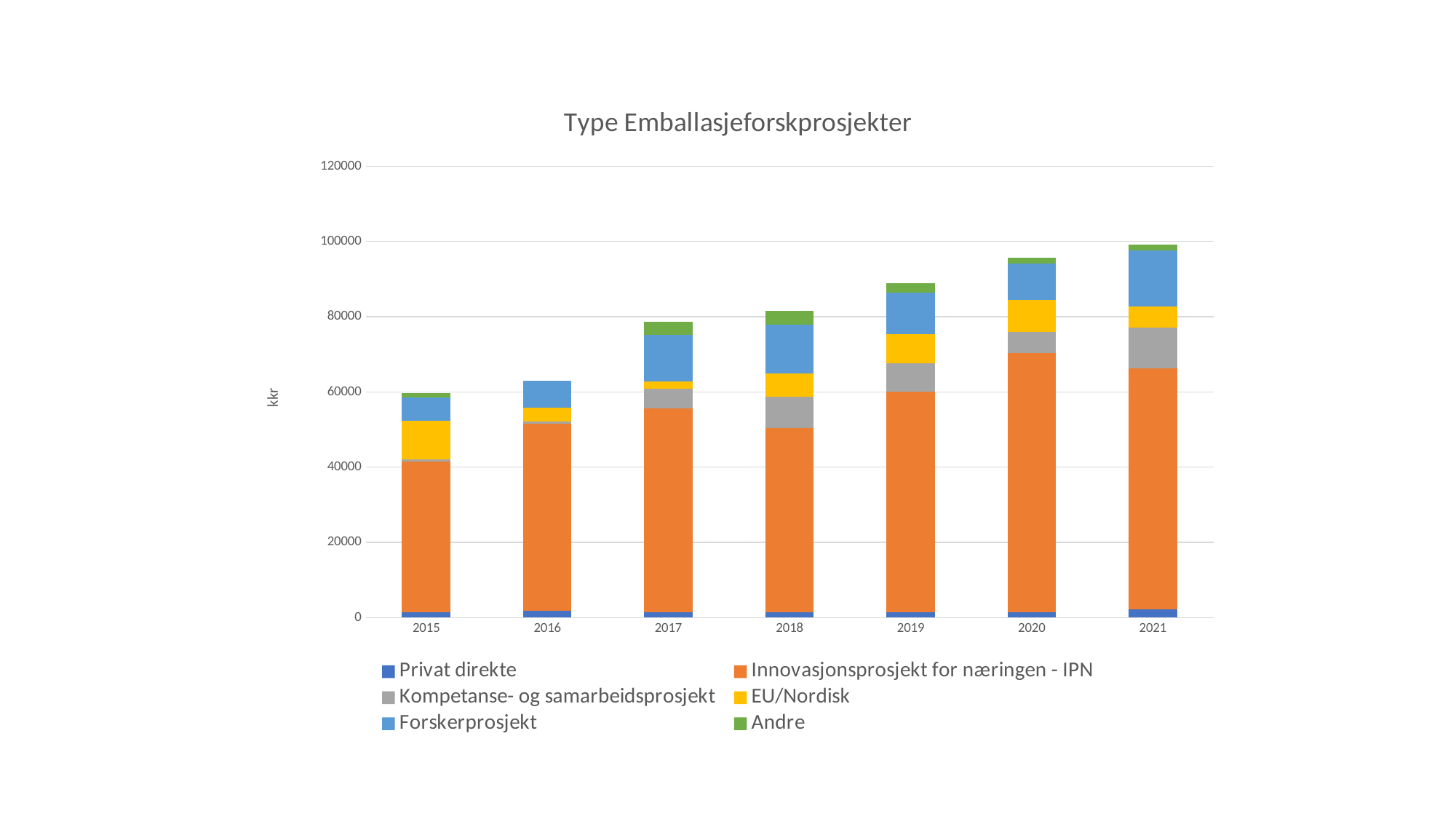
What label is shown on the y axis? kkr Which year has the highest total stacked bar? 2021 Is the total for 2017 greater or less than 60000? greater What is the title of the chart? Type Emballasjeforskprosjekter How many series does the legend list? 6 Do the total bar heights rise or fall from 2015 to 2021? rise Is the total for 2020 greater or less than 80000? greater What kind of chart is shown on the slide? Stacked bar chart How many years are shown on the x axis? 7 Is the total for 2016 greater or less than 80000? less Which year has the lowest total stacked bar? 2015